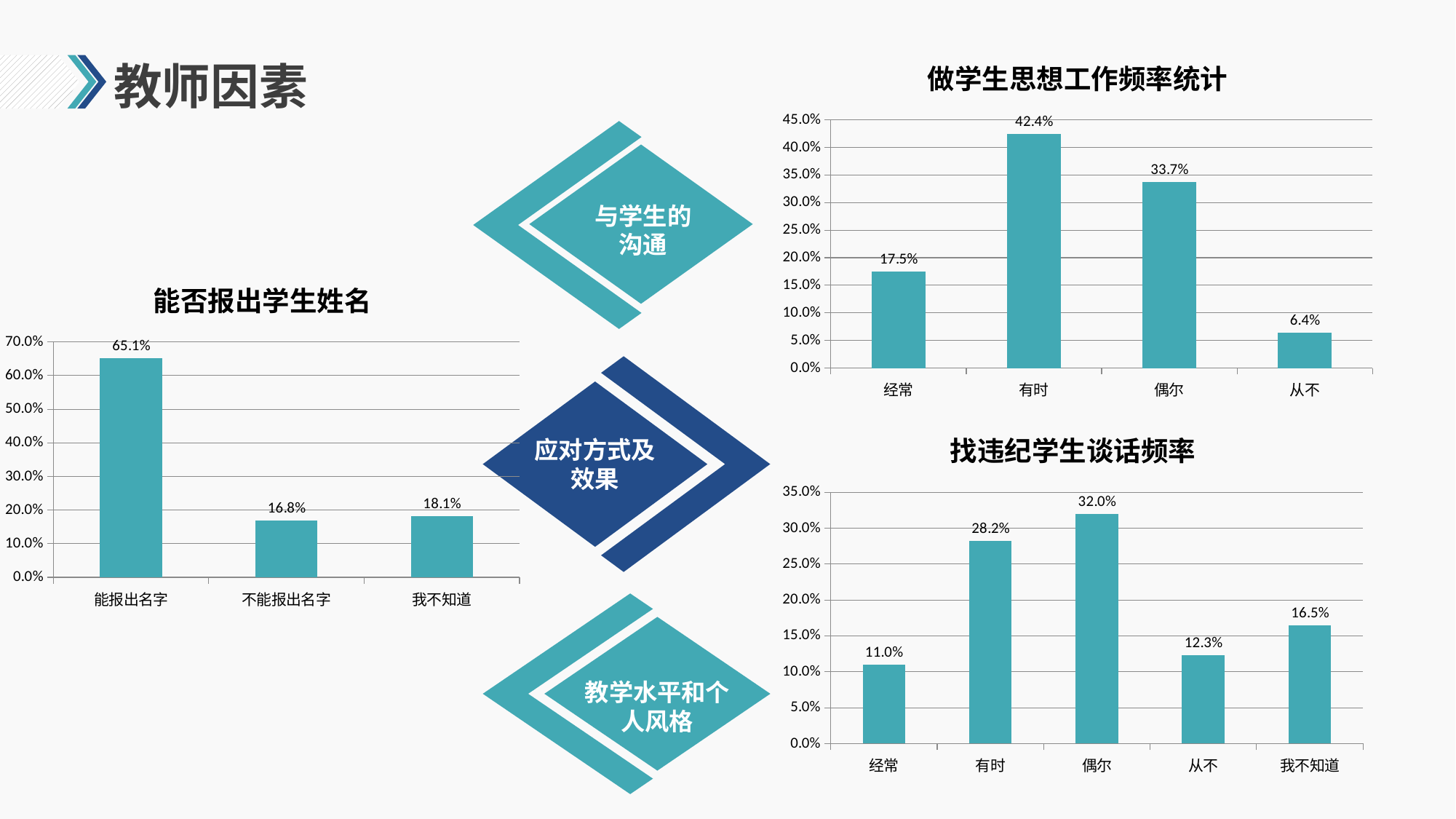
In the chart titled 做学生思想工作频率统计, what is the difference between 有时 and 从不? 36.0% In the chart titled 找违纪学生谈话频率, what is the value for 我不知道? 16.5% In the chart titled 做学生思想工作频率统计, what is the value for 偶尔? 33.7% In the chart titled 能否报出学生姓名, which category has the lowest value? 不能报出名字 What kind of chart is the chart titled 找违纪学生谈话频率? bar chart In the chart titled 能否报出学生姓名, what is the difference between 我不知道 and 不能报出名字? 1.3% In the chart titled 找违纪学生谈话频率, which category has the lowest value? 经常 In the chart titled 做学生思想工作频率统计, which category has the highest value? 有时 In the chart titled 能否报出学生姓名, what is the value for 能报出名字? 65.1% In the chart titled 做学生思想工作频率统计, which is larger, 经常 or 从不? 经常 In the chart titled 能否报出学生姓名, how many categories are shown? 3 In the chart titled 找违纪学生谈话频率, how many categories are shown? 5